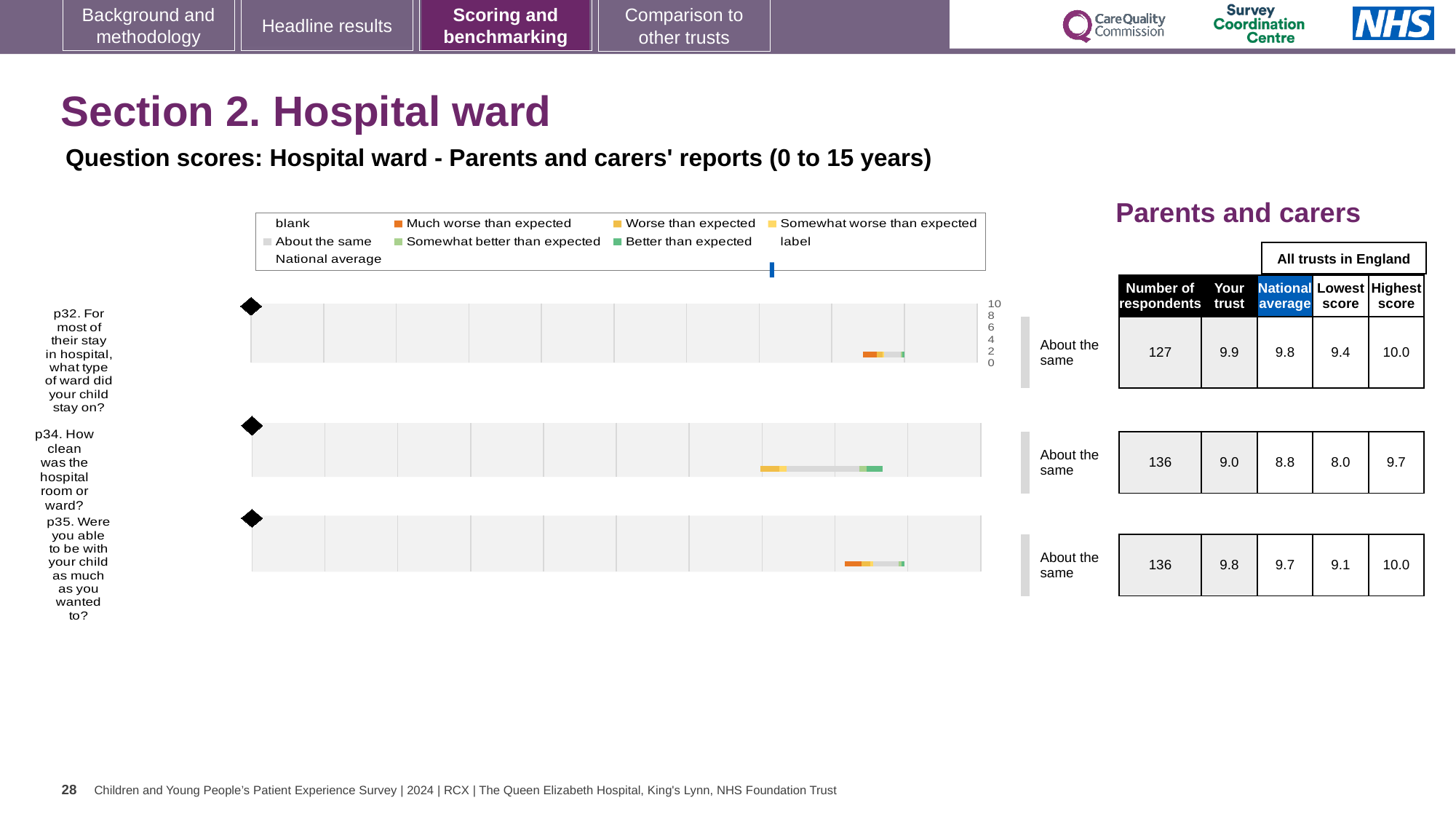
Is the 'Your trust' score for p32 higher or lower than the 'Your trust' score for p35? Higher What is the national average for p35 (Were you able to be with your child as much as you wanted to?)? 9.7 What is the difference between the 'Your trust' score and the national average for p34? 0.2 What is the 'Your trust' score for p34 (How clean was the hospital room or ward?)? 9.0 What is the lowest score among all trusts in England for p34? 8.0 What kind of chart is used to show the question scores? Bar chart What benchmark category is shown next to each of the three questions? About the same Which question has the lowest 'Your trust' score? p34. How clean was the hospital room or ward? Which legend entry is shown in orange? Much worse than expected What is the 'Your trust' score for p32 (For most of their stay in hospital, what type of ward did your child stay on?)? 9.9 How many questions (categories) are plotted in the chart? 3 How many respondents answered p32? 127